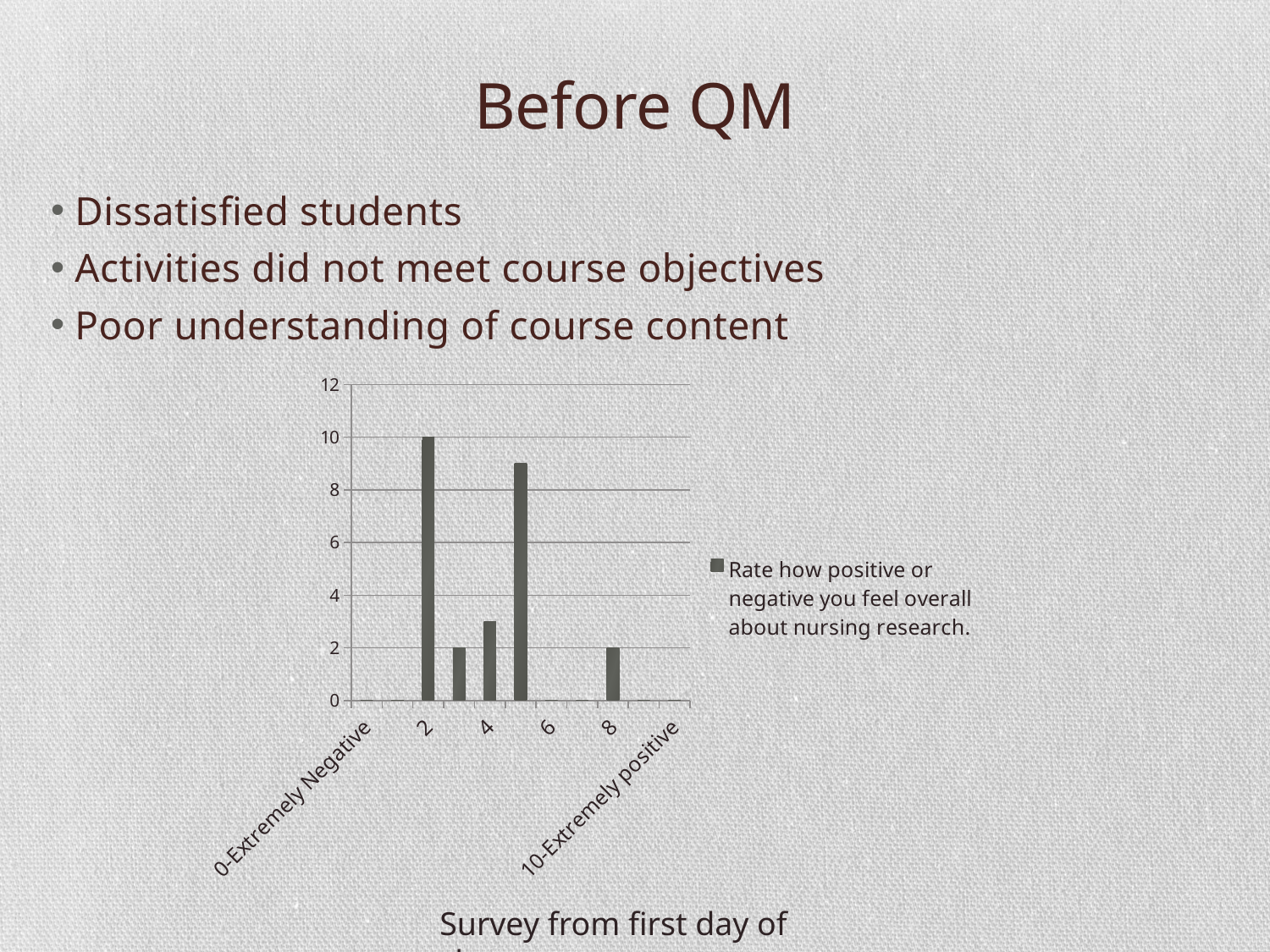
What is the legend entry for the series in the chart? Rate how positive or negative you feel overall about nursing research. What is the value of the bar at rating 2? 10 What kind of chart is shown on the slide? bar chart What is the difference between the bar at rating 2 and the bar at rating 8? 8 What is the highest value shown on the vertical axis? 12 Which rating has the tallest bar? 2 Is the value of the second tallest bar greater or less than 8? greater Is the value of the bar at rating 4 greater or less than 4? less How many series does the legend list? 1 How many bars are plotted in the chart? 5 Which is larger, the bar at rating 2 or the bar at rating 8? rating 2 What is the value of the bar at rating 8? 2